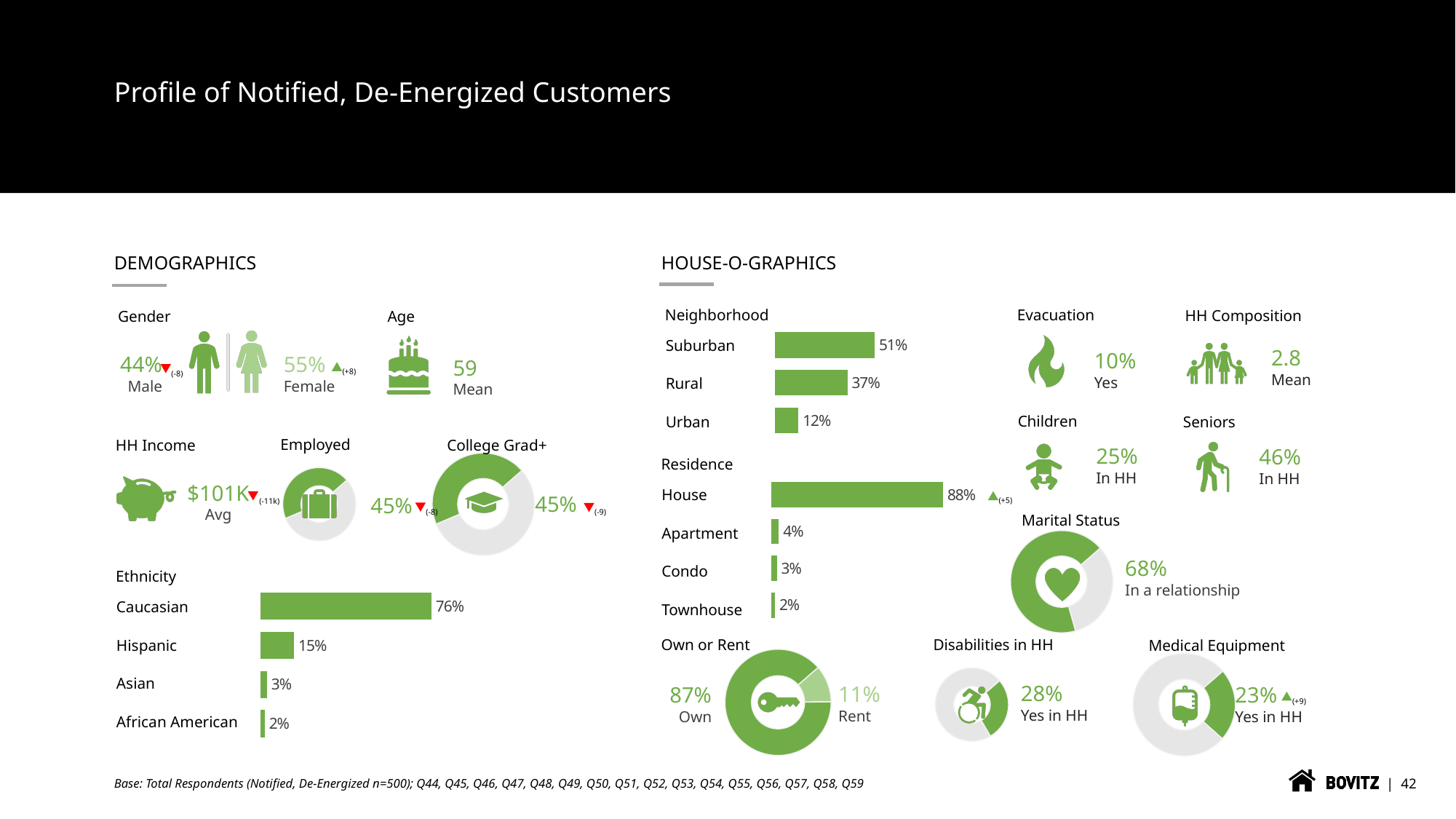
In the Own or Rent donut chart, what percentage is shown for Rent? 11% In the Residence bar chart, which is larger, Apartment or Condo? Apartment In the Ethnicity bar chart, which category has the lowest value? African American How many categories are shown in the Residence bar chart? 4 In the Residence bar chart, what percentage is shown for House? 88% How many categories are shown in the Ethnicity bar chart? 4 In the Neighborhood bar chart, what percentage is shown for Rural? 37% In the Ethnicity bar chart, what is the difference between the Hispanic and Asian values? 12% In the Neighborhood bar chart, what is the difference between the Suburban and Urban values? 39% In the Neighborhood bar chart, which category has the highest value? Suburban What kind of chart is used to show Own or Rent? Donut chart In the Ethnicity bar chart, what percentage is shown for Caucasian? 76%